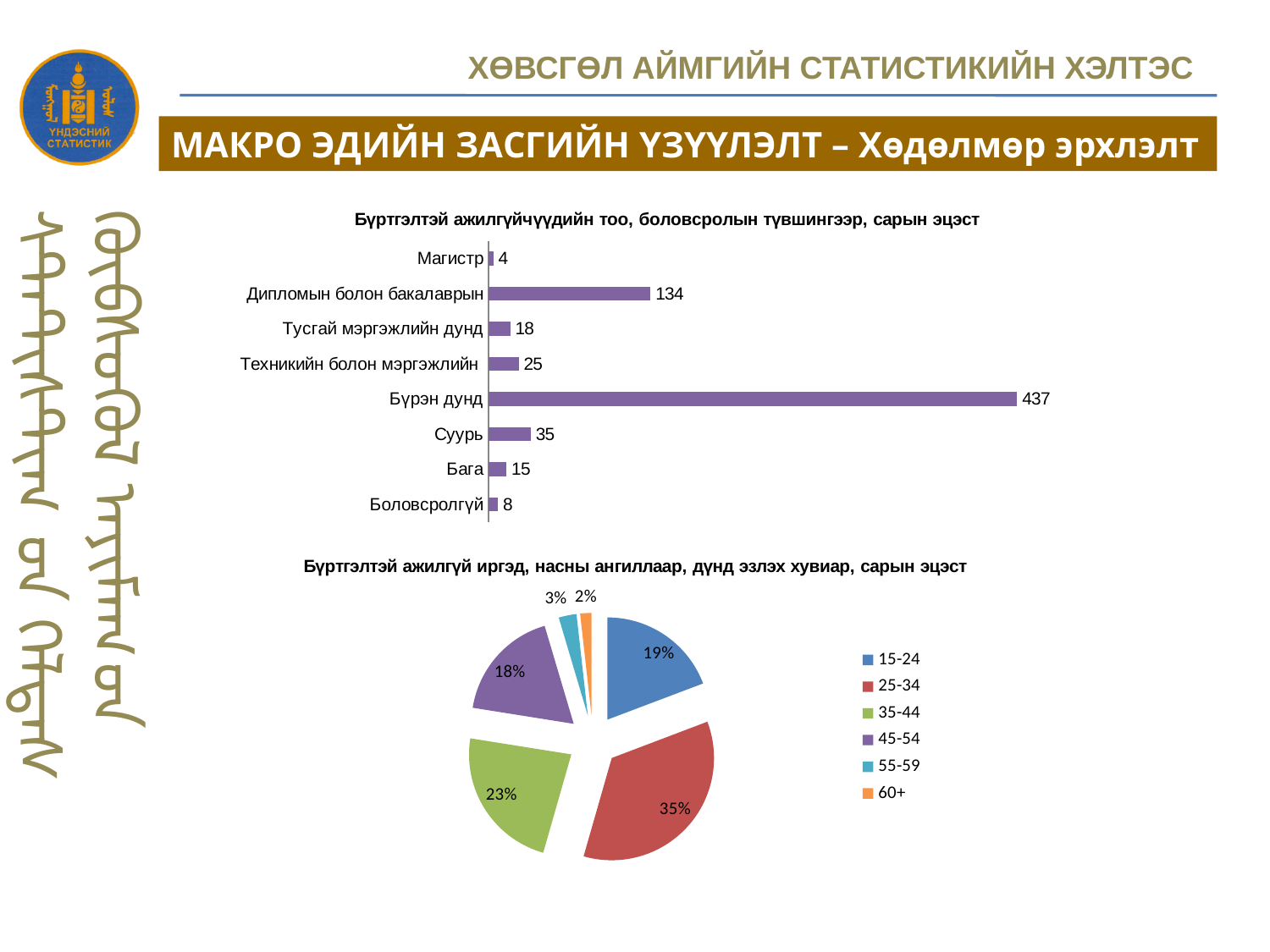
In the top chart, what is the value for Дипломын болон бакалаврын? 134 In the top chart, which education level has the lowest value? Магистр How many age groups does the legend of the bottom pie chart list? 6 In the top chart, which education level has the highest number of registered unemployed? Бүрэн дунд In the top chart (Бүртгэлтэй ажилгүйчүүдийн тоо, боловсролын түвшингээр), what is the value for Бүрэн дунд? 437 In the bottom pie chart (Бүртгэлтэй ажилгүй иргэд, насны ангиллаар), what share does the 25-34 age group have? 35% In the top chart, what is the difference between the values for Бүрэн дунд and Дипломын болон бакалаврын? 303 What type of chart is the top chart on the slide? Bar chart In the top chart, which is larger: the value for Суурь or the value for Техникийн болон мэргэжлийн? Суурь In the bottom pie chart, what is the difference between the shares of the 35-44 and 45-54 age groups? 5% In the bottom pie chart, which age group has the smallest share? 60+ How many education categories are shown in the top bar chart? 8